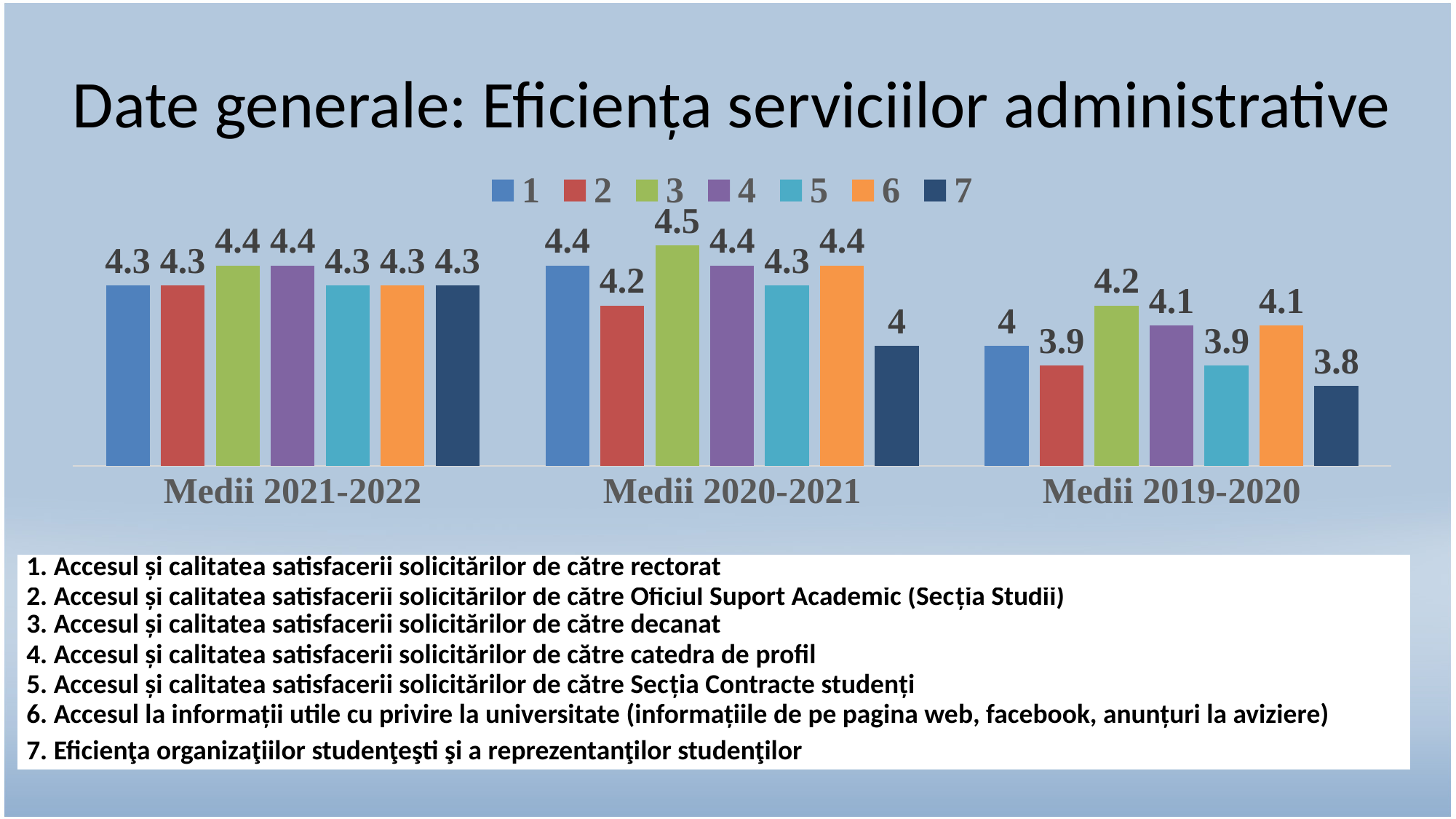
How many series does the legend list? 7 Which series has the lowest value in Medii 2019-2020? 7 What is the value for series 1 in Medii 2021-2022? 4.3 Which is larger in Medii 2019-2020: series 1 or series 7? series 1 What is the value for series 2 in Medii 2020-2021? 4.2 How many categories are shown on the x axis? 3 What is the difference between series 3 and series 2 in Medii 2019-2020? 0.3 What is the value for series 7 in Medii 2019-2020? 3.8 What kind of chart is shown on the slide? bar chart Which series has the highest value in Medii 2020-2021? 3 What is the value for series 3 in Medii 2020-2021? 4.5 What is the difference between series 3 and series 7 in Medii 2020-2021? 0.5